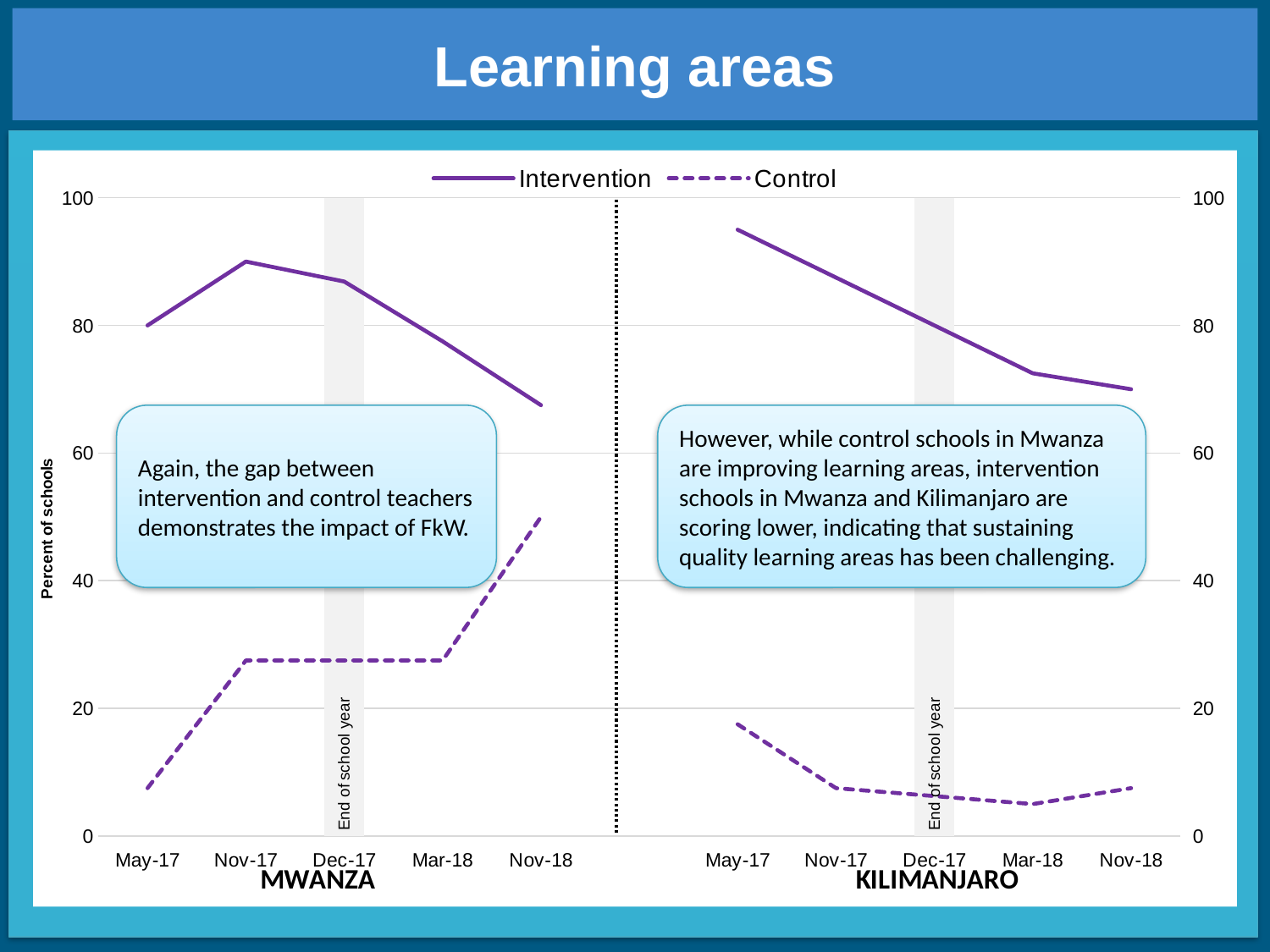
In the MWANZA panel, is the Intervention value for Nov-17 greater or less than 80? greater How many series does the chart legend list? 2 In the KILIMANJARO panel, is the Intervention value for May-17 greater or less than 80? greater In the MWANZA panel, at which time point is the Intervention line highest? Nov-17 How many time points are plotted on the x axis of the MWANZA panel? 5 What kind of chart is shown on the slide? line chart In the KILIMANJARO panel, does the Intervention line rise or fall from May-17 to Nov-18? fall In the MWANZA panel, does the Control line rise or fall from May-17 to Nov-18? rise In the MWANZA panel, which series has the larger value at Nov-18, Intervention or Control? Intervention In the MWANZA panel, is the Control value for May-17 greater or less than 20? less What are the two series named in the legend? Intervention and Control